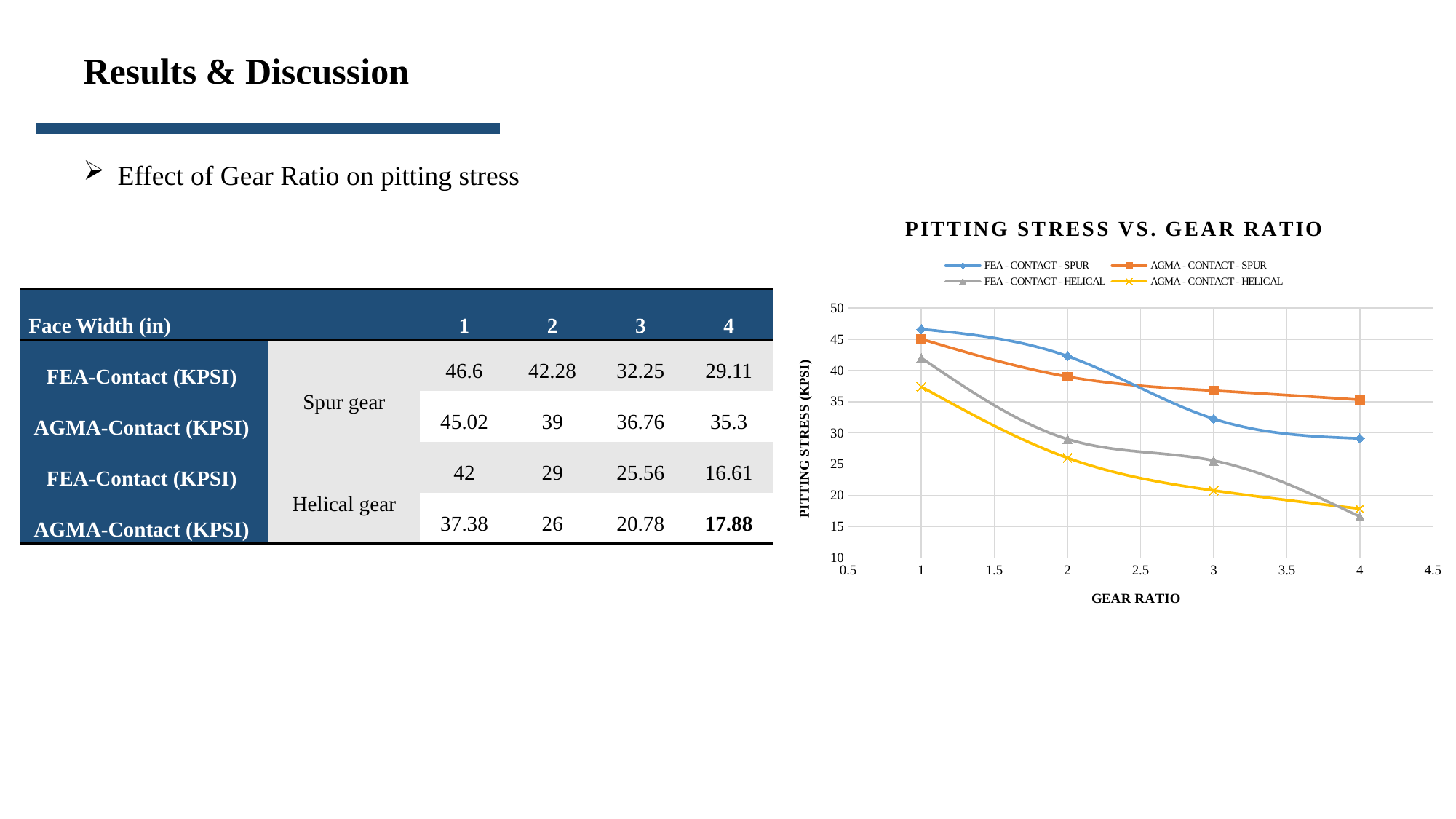
At gear ratio 4, which is larger: FEA - CONTACT - SPUR or AGMA - CONTACT - SPUR? AGMA - CONTACT - SPUR How many series does the legend of the Pitting Stress vs. Gear Ratio chart list? 4 How many data points are plotted for the FEA - CONTACT - SPUR series? 4 Which series has the lowest pitting stress at gear ratio 3? AGMA - CONTACT - HELICAL Is the value for AGMA - CONTACT - HELICAL at gear ratio 4 greater or less than 20? less At gear ratio 3, which is larger: FEA - CONTACT - HELICAL or AGMA - CONTACT - HELICAL? FEA - CONTACT - HELICAL What kind of chart is shown on the slide? line chart What is the title of the chart? PITTING STRESS VS. GEAR RATIO Which series has the highest pitting stress at gear ratio 1? FEA - CONTACT - SPUR Is the value for AGMA - CONTACT - SPUR at gear ratio 3 greater or less than 35? greater What is the title of the x axis of the chart? GEAR RATIO Do the values of the AGMA - CONTACT - HELICAL series rise or fall as gear ratio increases? fall